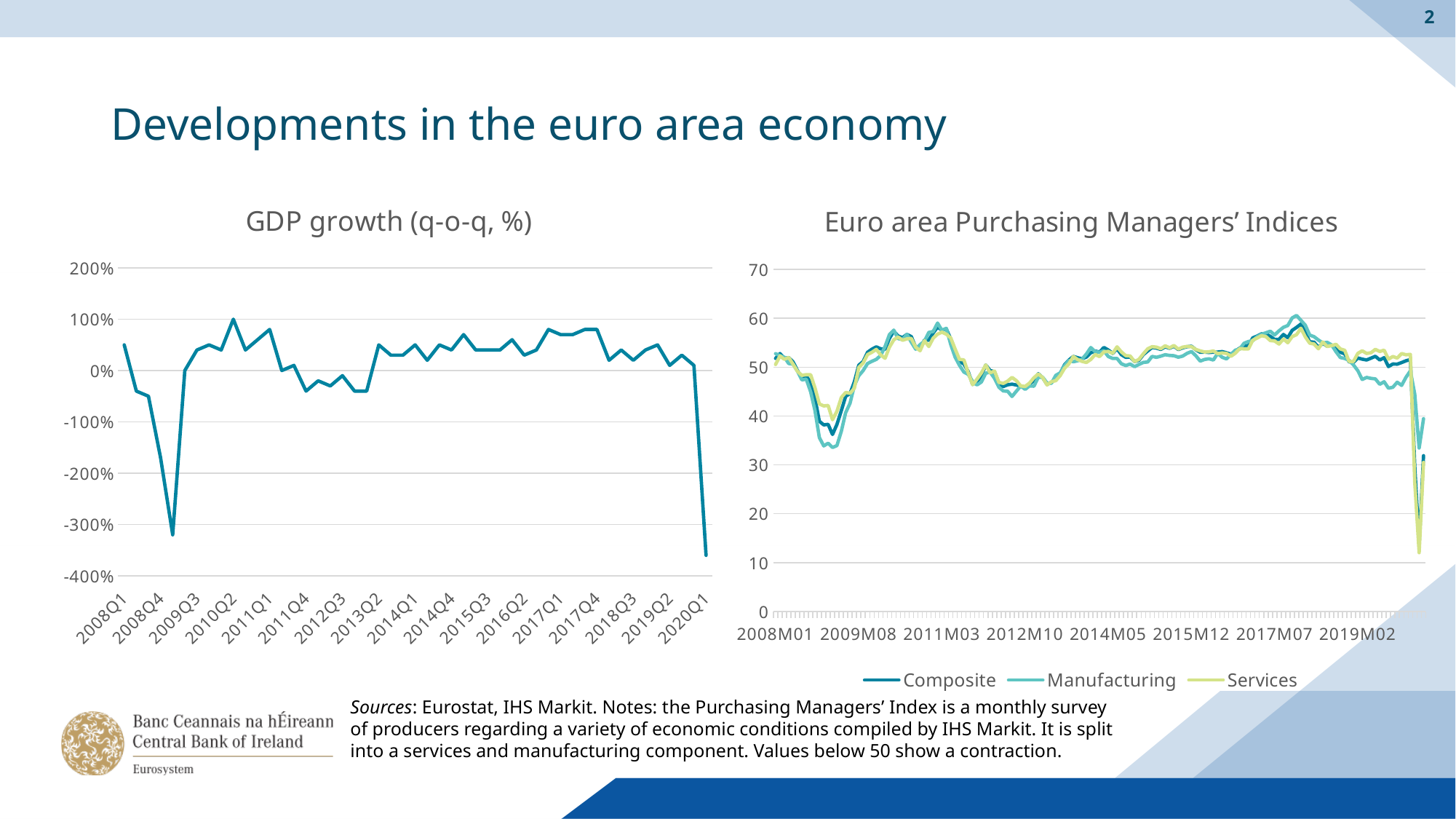
In the 'Euro area Purchasing Managers' Indices' chart, is the Composite value at 2008M01 greater or less than 50? greater In the 'Euro area Purchasing Managers' Indices' chart, do the values rise or fall between 2008M01 and early 2009? fall What kind of chart is the 'GDP growth (q-o-q, %)' chart? line chart What kind of chart is the 'Euro area Purchasing Managers' Indices' chart? line chart In the 'Euro area Purchasing Managers' Indices' chart, is the Manufacturing value at its 2009 low greater or less than 40? less In the 'Euro area Purchasing Managers' Indices' chart, which series are listed in the legend? Composite, Manufacturing, Services How many series does the legend of the 'Euro area Purchasing Managers' Indices' chart list? 3 In the 'GDP growth (q-o-q, %)' chart, which quarter has the lowest value? 2020Q1 In the 'GDP growth (q-o-q, %)' chart, is the value for 2020Q1 greater or less than -300%? less What is the highest value shown on the y axis of the 'GDP growth (q-o-q, %)' chart? 200%